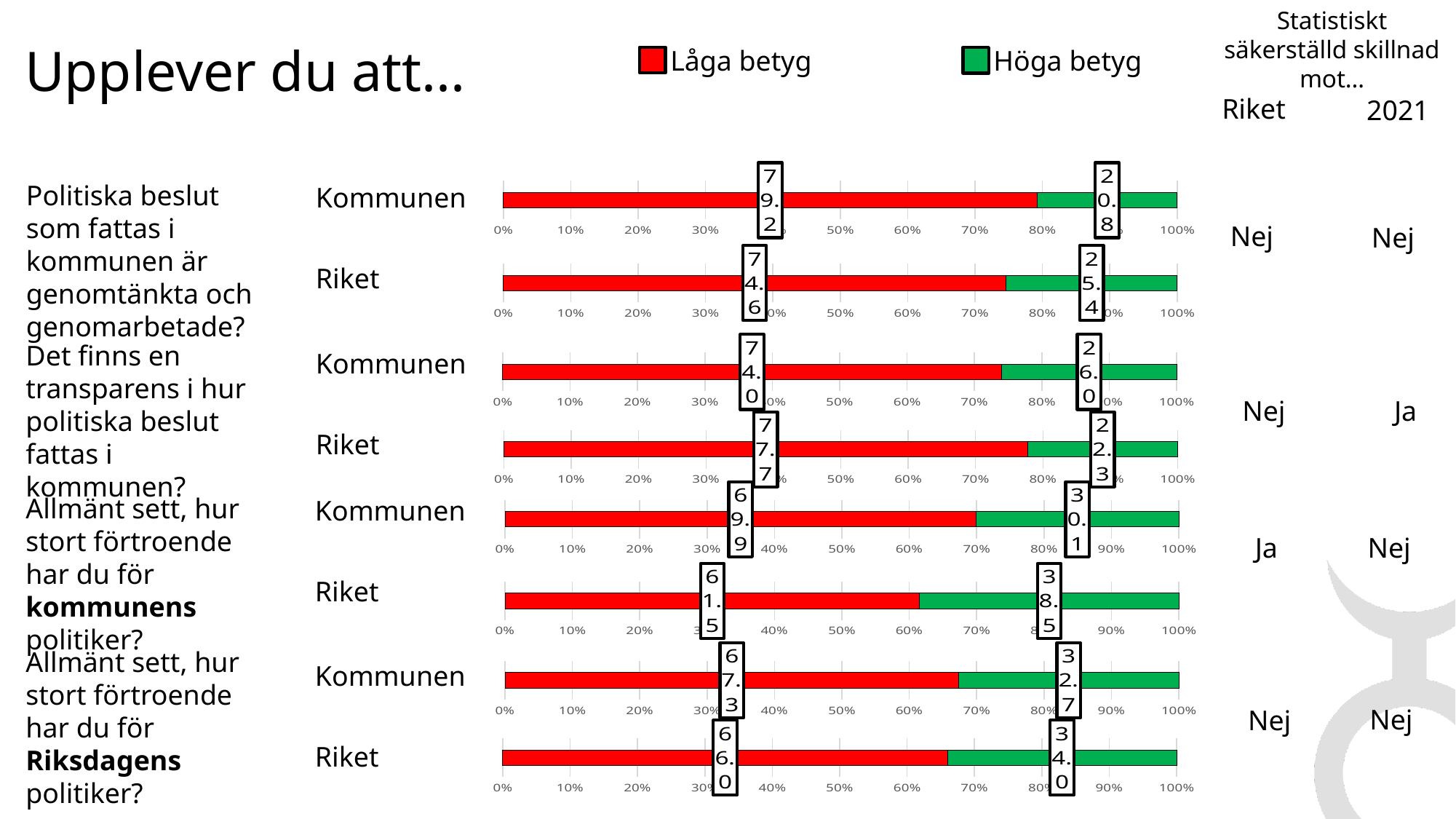
In the chart for 'Allmänt sett, hur stort förtroende har du för kommunens politiker?', what is the value of Höga betyg for Riket? 38.5 How many series does the legend list? 2 In the chart for 'Politiska beslut som fattas i kommunen är genomtänkta och genomarbetade?', what is the value of Låga betyg for Kommunen? 79.2 In the chart for 'Allmänt sett, hur stort förtroende har du för kommunens politiker?', what is the difference between Låga betyg for Kommunen and Låga betyg for Riket? 8.4 What kind of chart is used on the slide? Stacked bar chart In the chart for 'Det finns en transparens i hur politiska beslut fattas i kommunen?', what is the value of Höga betyg for Kommunen? 26.0 In the chart for 'Allmänt sett, hur stort förtroende har du för Riksdagens politiker?', which is larger: Höga betyg for Kommunen or Höga betyg for Riket? Riket In the chart for 'Det finns en transparens i hur politiska beslut fattas i kommunen?', what is the value of Låga betyg for Riket? 77.7 In the chart for 'Politiska beslut som fattas i kommunen är genomtänkta och genomarbetade?', is the Låga betyg value for Kommunen greater or less than 70%? greater What colour represents Höga betyg in the legend? Green In the chart for 'Politiska beslut som fattas i kommunen är genomtänkta och genomarbetade?', what is the value of Höga betyg for Riket? 25.4 In the chart for 'Allmänt sett, hur stort förtroende har du för Riksdagens politiker?', what is the value of Låga betyg for Kommunen? 67.3